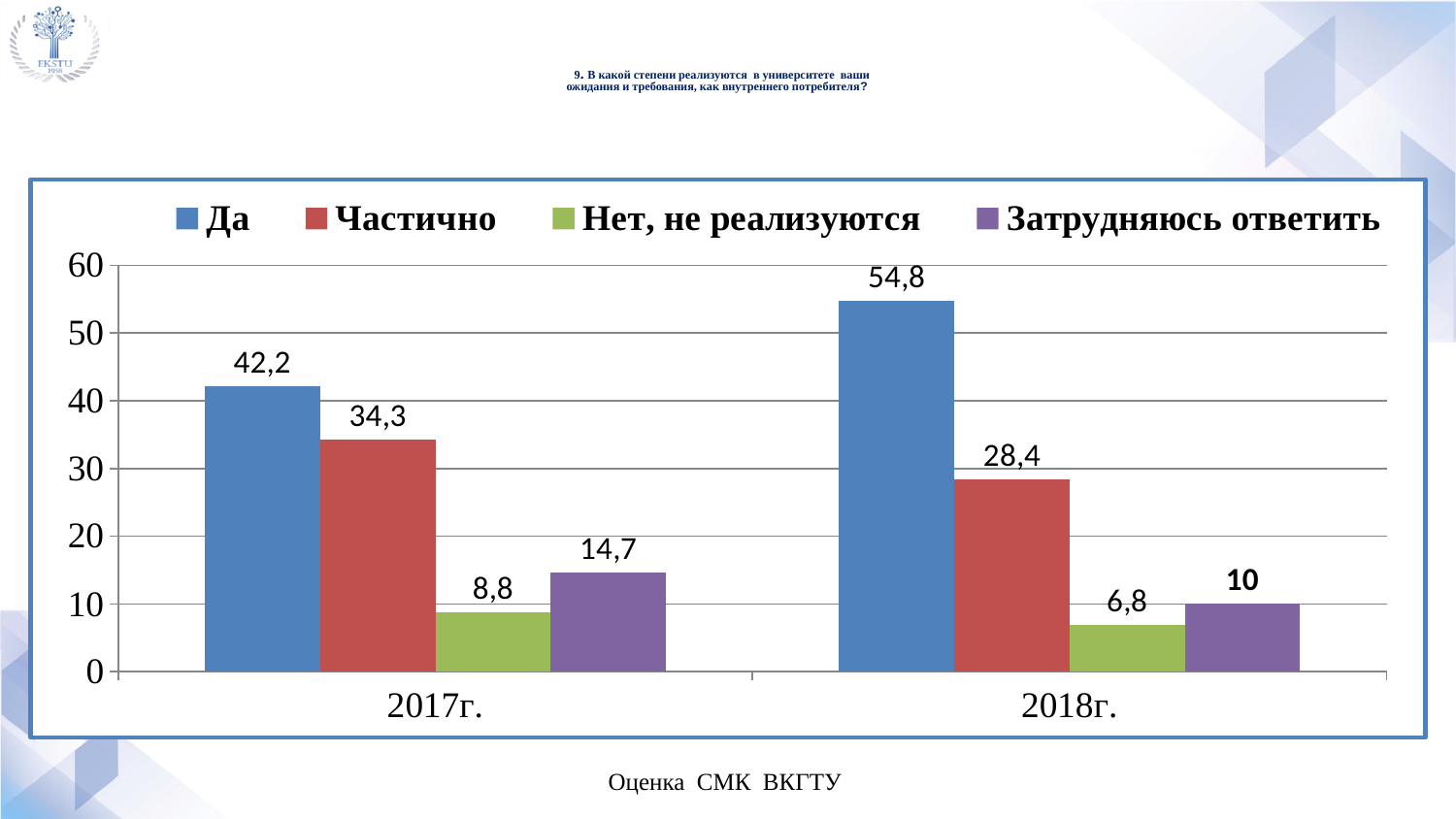
How many series does the legend list? 4 What is the value for "Затрудняюсь ответить" in 2018г.? 10 What kind of chart is shown on the slide? Bar chart Does the value for "Затрудняюсь ответить" rise or fall from 2017г. to 2018г.? Fall What is the value for "Нет, не реализуются" in 2017г.? 8,8 What is the difference between the "Да" values for 2018г. and 2017г.? 12,6 Which series has the lowest value in 2018г.? Нет, не реализуются What is the value for "Частично" in 2017г.? 34,3 Which series has the highest value in 2017г.? Да How many categories are shown on the x axis? 2 What is the value for "Да" in 2018г.? 54,8 Which is larger: "Частично" in 2017г. or "Частично" in 2018г.? Частично in 2017г.